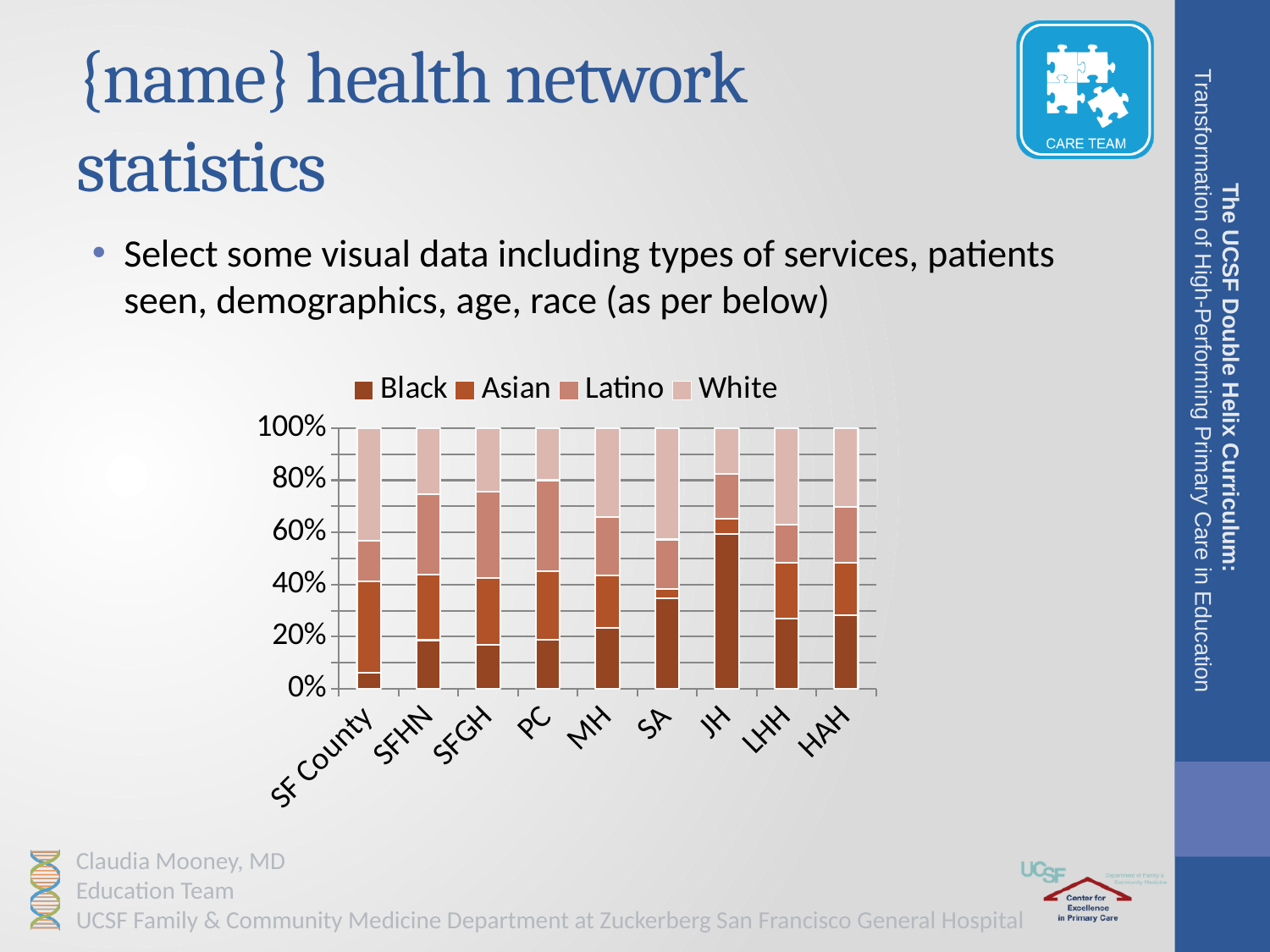
How many series does the chart's legend list? 4 How many categories are shown along the x axis of the chart? 9 Is the Black share for JH greater or less than 40%? greater Is the Black share for SF County greater or less than 20%? less What is the total of the stacked bar for JH? 100% Which series is plotted at the bottom of each stacked bar? Black Which has the larger Black share, SA or SFHN? SA Which category has the largest Black share in the chart? JH What kind of chart is shown on the slide? stacked bar chart Which category has the largest Asian share in the chart? SF County Is the Black share for SA greater or less than 20%? greater Which category has the smallest Black share in the chart? SF County